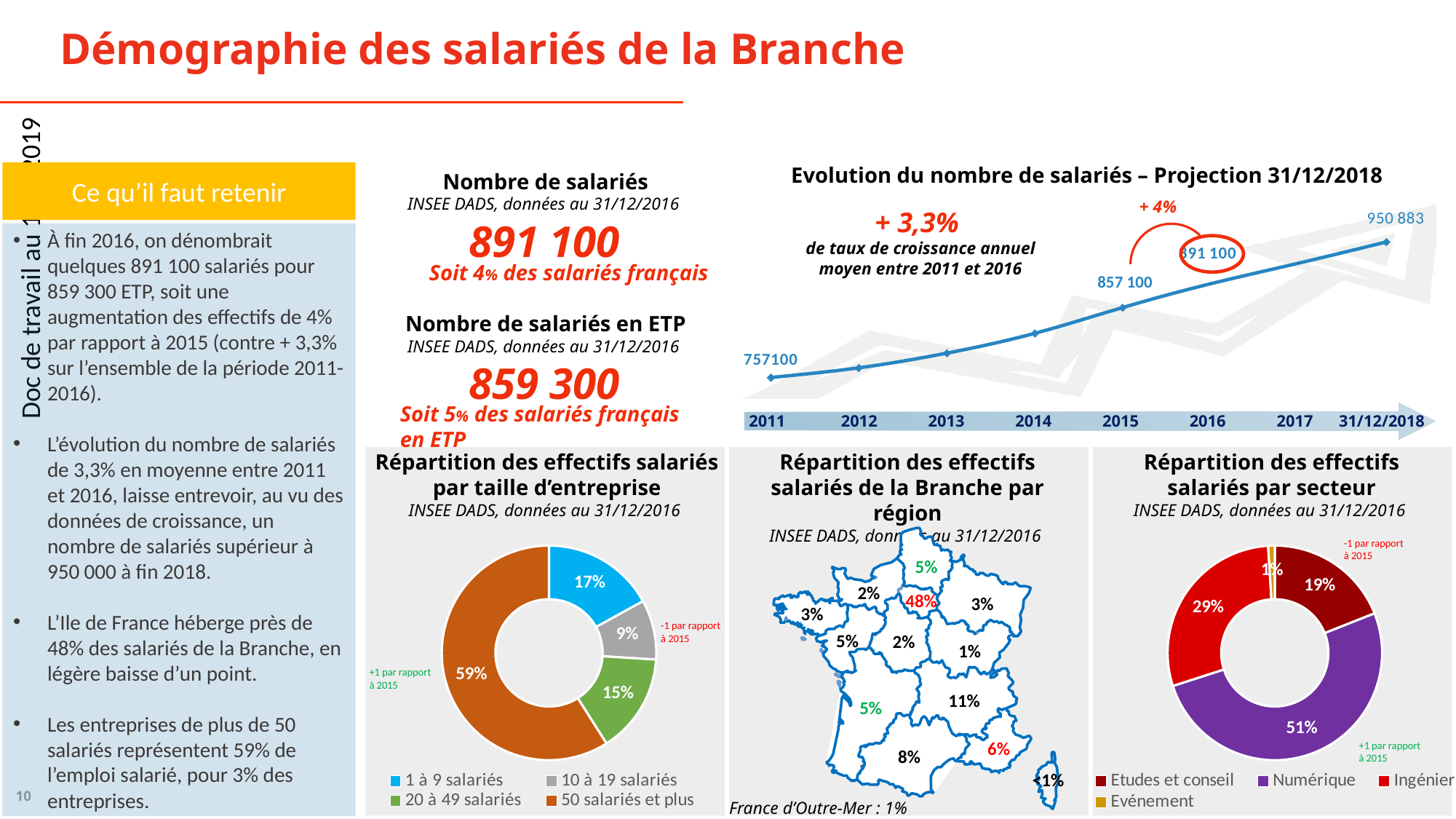
In the chart 'Evolution du nombre de salariés – Projection 31/12/2018', what is the projected value for 31/12/2018? 950 883 In the chart 'Répartition des effectifs salariés par taille d'entreprise', which category has the smallest share? 10 à 19 salariés In the chart 'Répartition des effectifs salariés par secteur', what share does 'Numérique' represent? 51% In the chart 'Evolution du nombre de salariés – Projection 31/12/2018', do the values rise or fall from 2011 to 31/12/2018? rise How many points are on the x axis of the chart 'Evolution du nombre de salariés – Projection 31/12/2018'? 8 In the chart 'Répartition des effectifs salariés par taille d'entreprise', what share do companies with '50 salariés et plus' represent? 59% In the chart 'Evolution du nombre de salariés – Projection 31/12/2018', what is the value for 2011? 757100 What kind of chart is 'Répartition des effectifs salariés par taille d'entreprise'? donut chart In the chart 'Répartition des effectifs salariés par secteur', which is larger: 'Etudes et conseil' or 'Numérique'? Numérique In the chart 'Répartition des effectifs salariés par taille d'entreprise', what is the difference between the shares of '1 à 9 salariés' and '20 à 49 salariés'? 2% What kind of chart is 'Evolution du nombre de salariés – Projection 31/12/2018'? line chart In the chart 'Evolution du nombre de salariés – Projection 31/12/2018', what is the value for 2015? 857 100